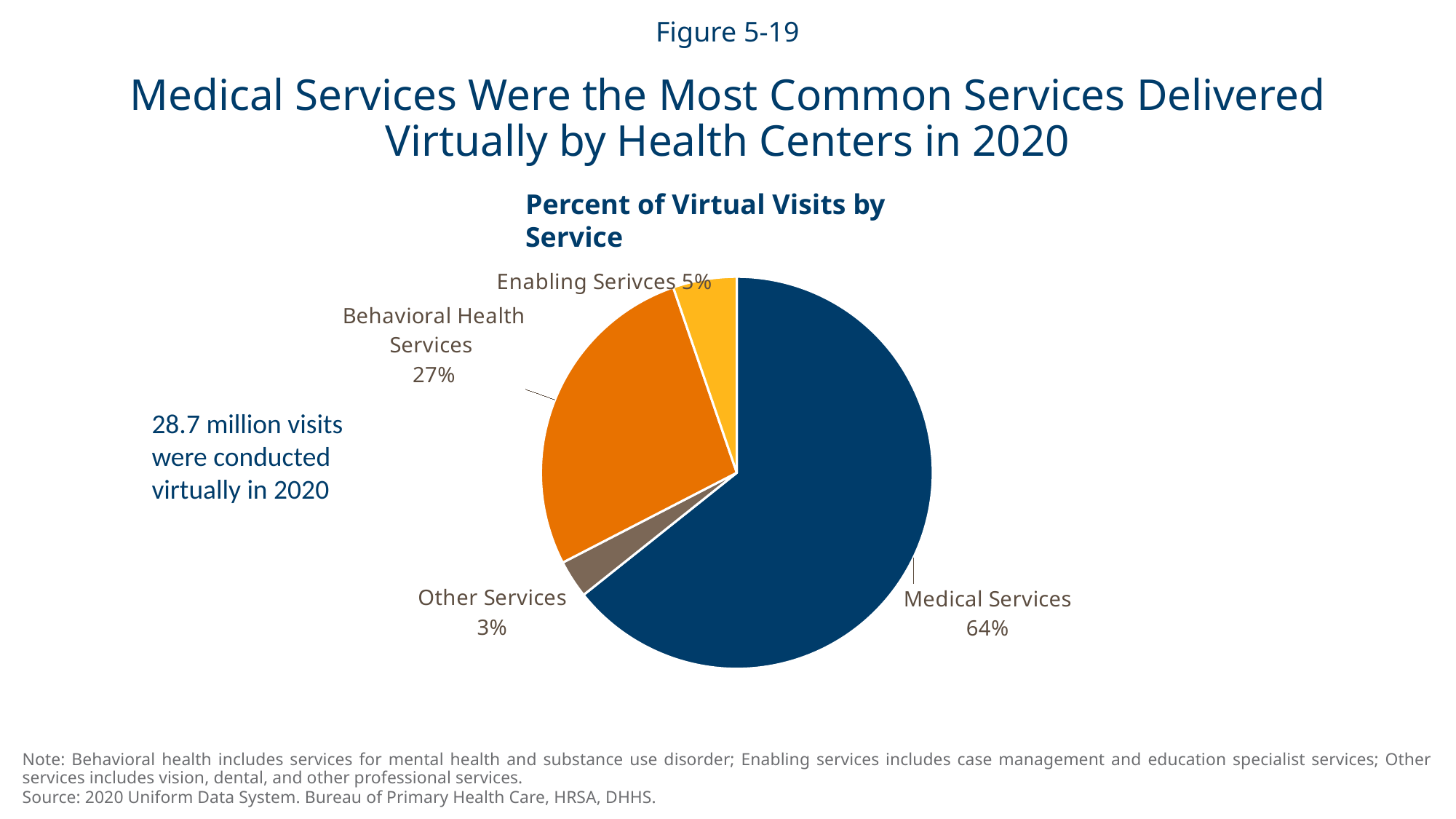
How many service categories are shown in the pie chart? 4 According to the slide, how many visits were conducted virtually in 2020? 28.7 million What percent of virtual visits were for Medical Services? 64% What type of chart is shown on the slide? Pie chart Which service category has the smallest share of virtual visits? Other Services What percent of virtual visits were for Behavioral Health Services? 27% Which service category has the largest share of virtual visits? Medical Services What is the difference in percentage points between Medical Services and Behavioral Health Services? 37 What percent of virtual visits were for Other Services? 3% What percent of virtual visits were for Enabling Services? 5% Which has a larger share of virtual visits, Enabling Services or Other Services? Enabling Services What is the title of the pie chart? Percent of Virtual Visits by Service